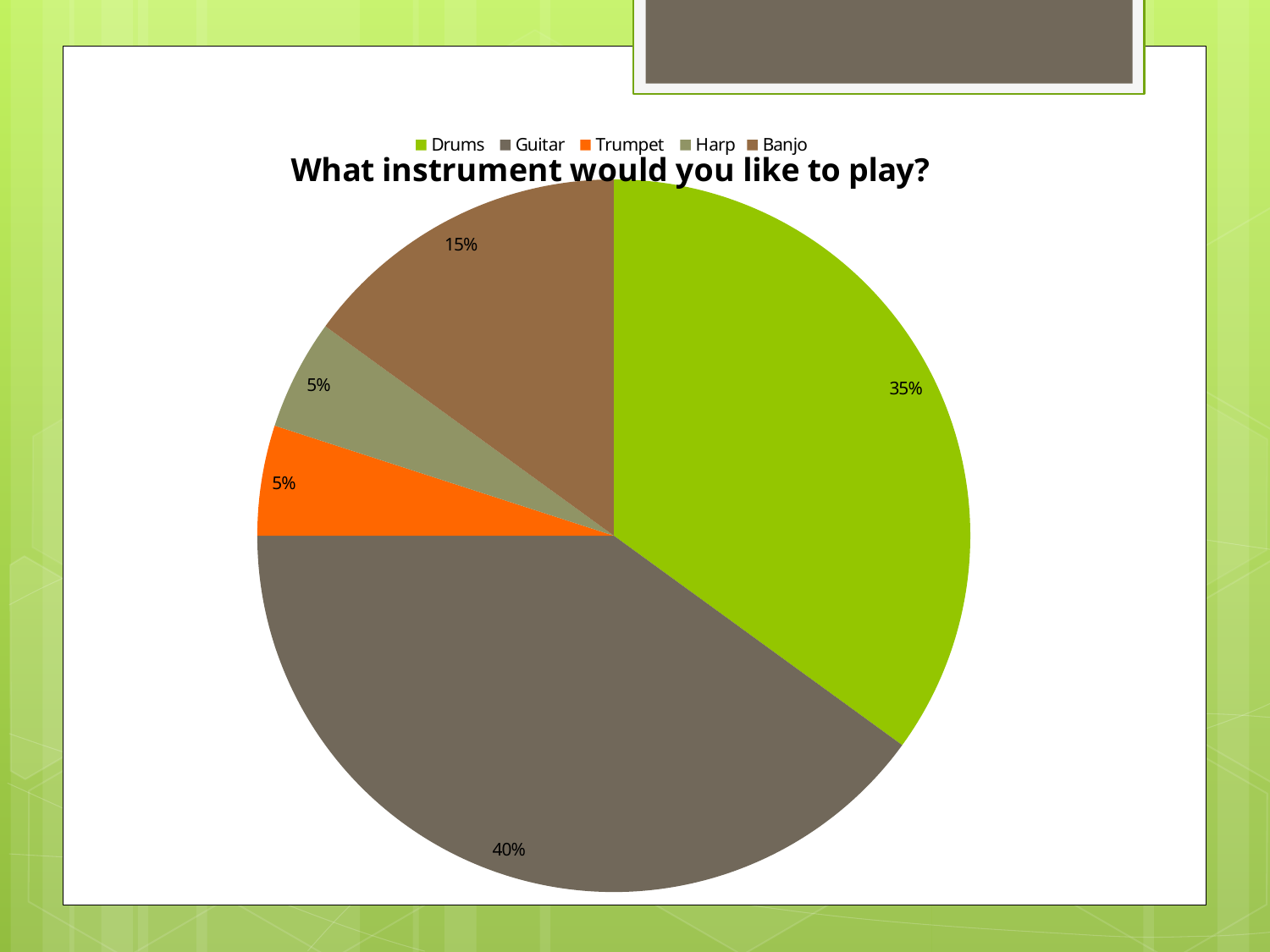
Which is larger, the share for Banjo or the share for Harp? Banjo What type of chart is shown on the slide? pie chart What is the difference between the Guitar and Drums shares? 5% Which colour represents Trumpet in the chart? orange What percentage of the pie is Drums? 35% What percentage of the pie is Banjo? 15% What is the title of the chart? What instrument would you like to play? What percentage of the pie is Guitar? 40% What is the difference between the Banjo and Harp shares? 10% What percentage of the pie is Trumpet? 5% How many categories does the legend list? 5 Which instrument has the largest share of the pie? Guitar